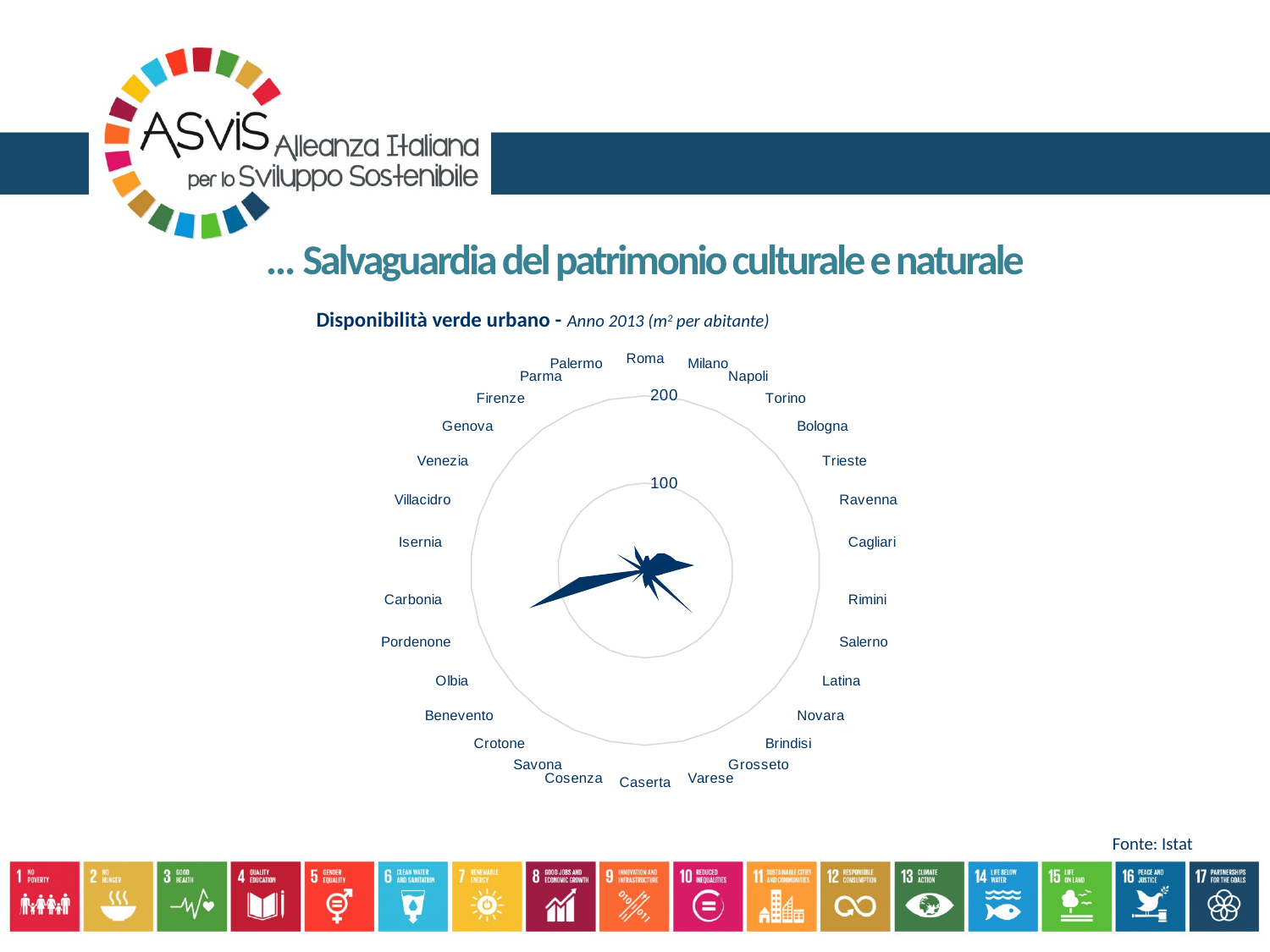
Is the value for Milano greater or less than 100? less Is the value for Cagliari greater or less than 100? less Is the value for Carbonia greater or less than 100? less Which city has the highest value on the radar chart? Pordenone What is the title of the chart? Disponibilità verde urbano - Anno 2013 (m² per abitante) What kind of chart is shown on the slide? radar chart What is the highest tick value shown on the radar chart's axis? 200 Which has the larger value, Carbonia or Roma? Carbonia How many cities are plotted on the radar chart? 30